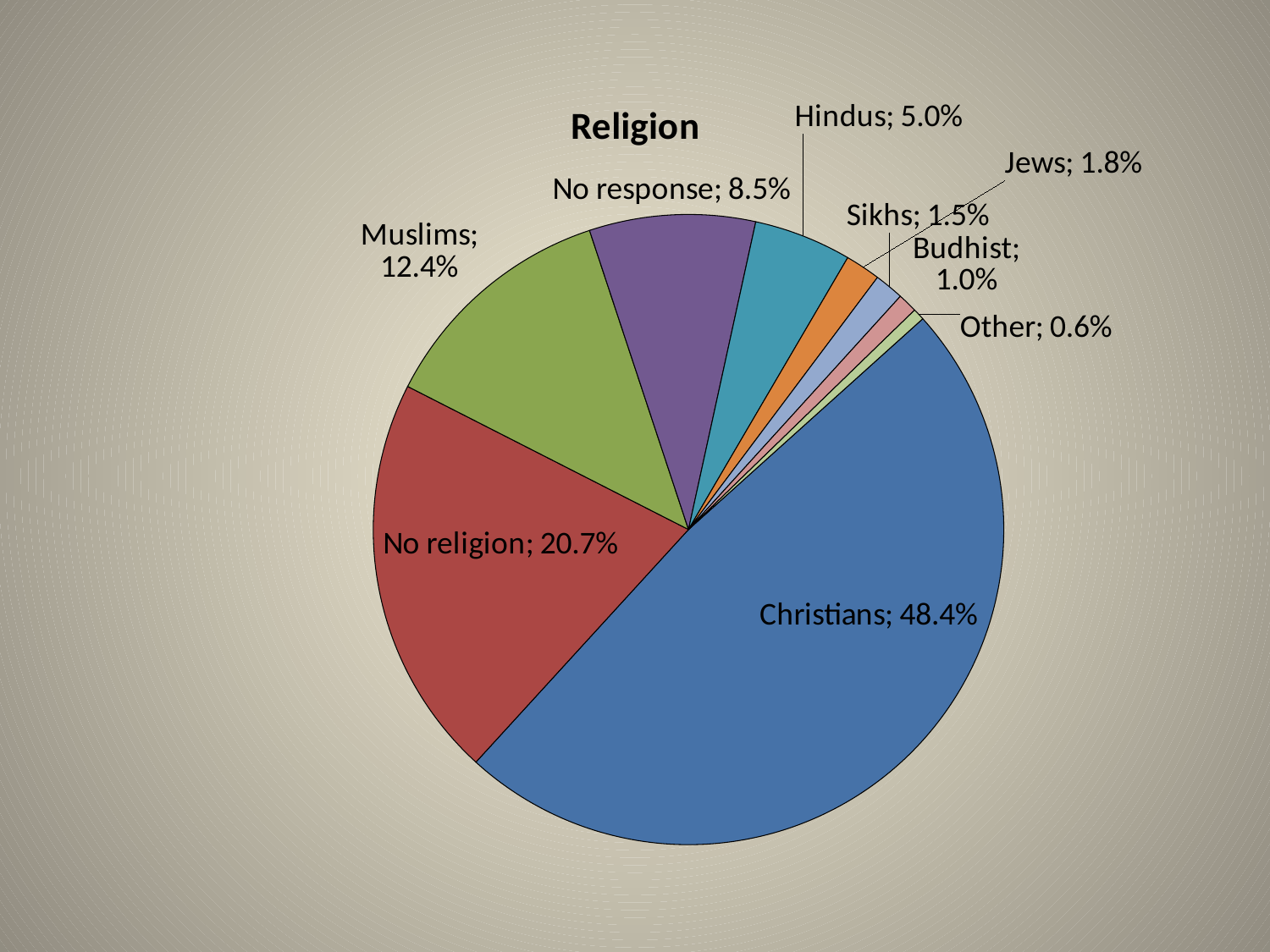
What is the value for Hindus? 5.0% What is the value for Muslims? 12.4% What share of the pie is Christians? 48.4% What is the value for Budhist? 1.0% How many categories are shown in the pie chart? 9 What kind of chart is shown on the slide? Pie chart What is the title of the chart? Religion What is the difference between the Christians and No religion shares? 27.7% What is the value for No religion? 20.7% Which category has the largest slice? Christians Which category has the smallest slice? Other Which is larger, No response or Muslims? Muslims